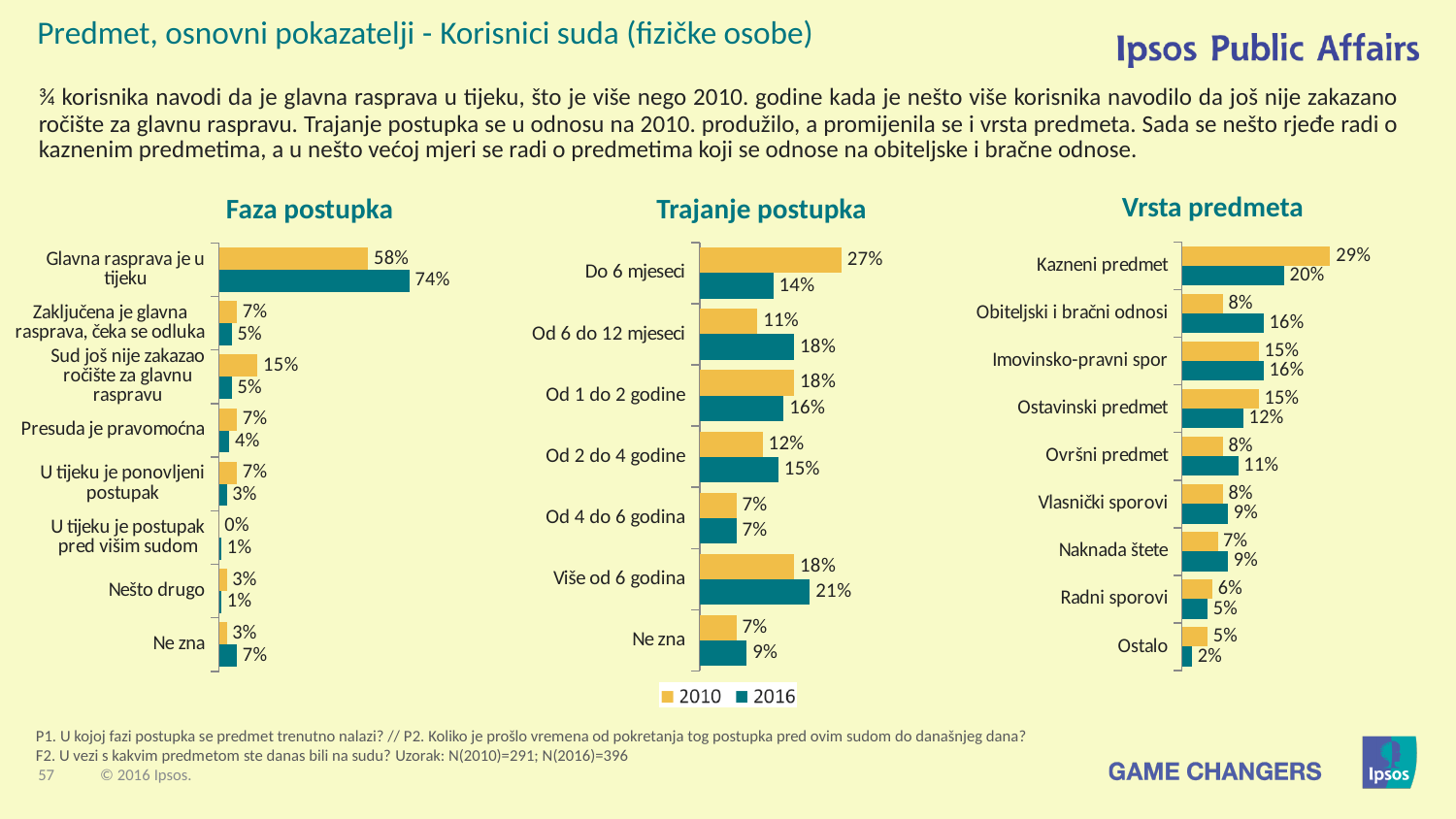
In the 'Vrsta predmeta' chart, what is the difference between the 2016 and 2010 values for 'Obiteljski i bračni odnosi'? 8% What type of chart is the 'Trajanje postupka' chart? Bar chart In the 'Trajanje postupka' chart, which category has the highest 2016 value? Više od 6 godina How many series does the legend list? 2 In the 'Faza postupka' chart, what is the 2010 value for 'Sud još nije zakazao ročište za glavnu raspravu'? 15% In the 'Trajanje postupka' chart, which is larger for 'Od 6 do 12 mjeseci': the 2010 value or the 2016 value? 2016 In the 'Trajanje postupka' chart, what is the 2010 value for 'Do 6 mjeseci'? 27% How many categories are shown in the 'Vrsta predmeta' chart? 9 In the 'Vrsta predmeta' chart, what is the 2016 value for 'Kazneni predmet'? 20% In the 'Vrsta predmeta' chart, which category has the lowest 2016 value? Ostalo In the 'Faza postupka' chart, what is the difference between the 2016 and 2010 values for 'Glavna rasprava je u tijeku'? 16% In the 'Faza postupka' chart, what is the 2016 value for 'Glavna rasprava je u tijeku'? 74%